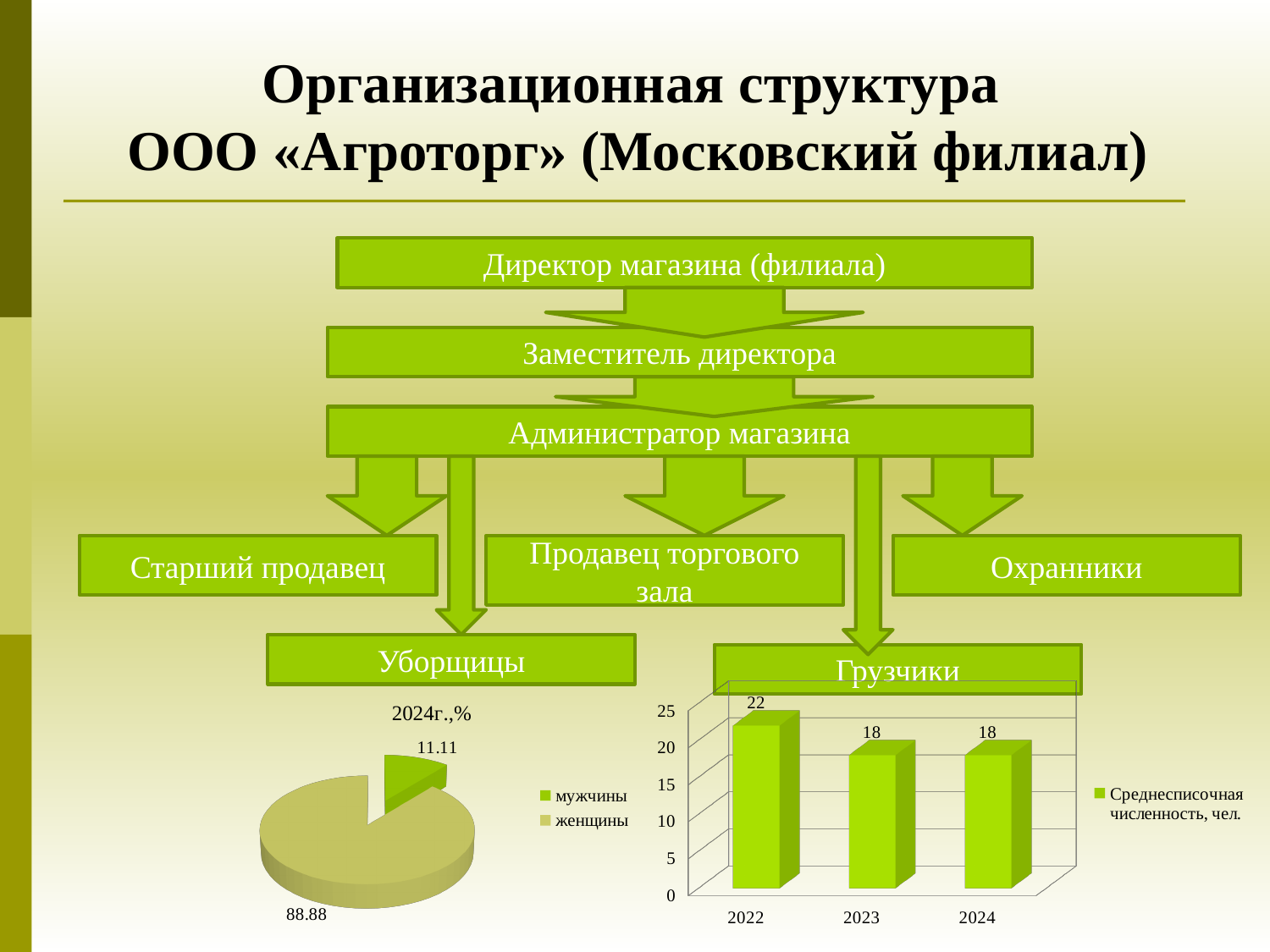
What kind of chart is the chart on the right, showing values for 2022, 2023 and 2024? bar chart In the bar chart on the right, which year has the highest value? 2022 In the bar chart on the right, how many years are shown on the x axis? 3 In the bar chart on the right, what is the value for 2022? 22 In the pie chart titled "2024г.,%", which slice is the largest? женщины What kind of chart is the chart on the left, titled "2024г.,%"? pie chart In the bar chart on the right, what series does the legend list? Среднесписочная численность, чел. In the bar chart on the right, what is the value for 2023? 18 In the pie chart titled "2024г.,%", how many slices are there? 2 In the pie chart titled "2024г.,%", what is the value for мужчины? 11.11 In the bar chart on the right, what is the difference between the values for 2022 and 2024? 4 In the pie chart titled "2024г.,%", what is the value for женщины? 88.88